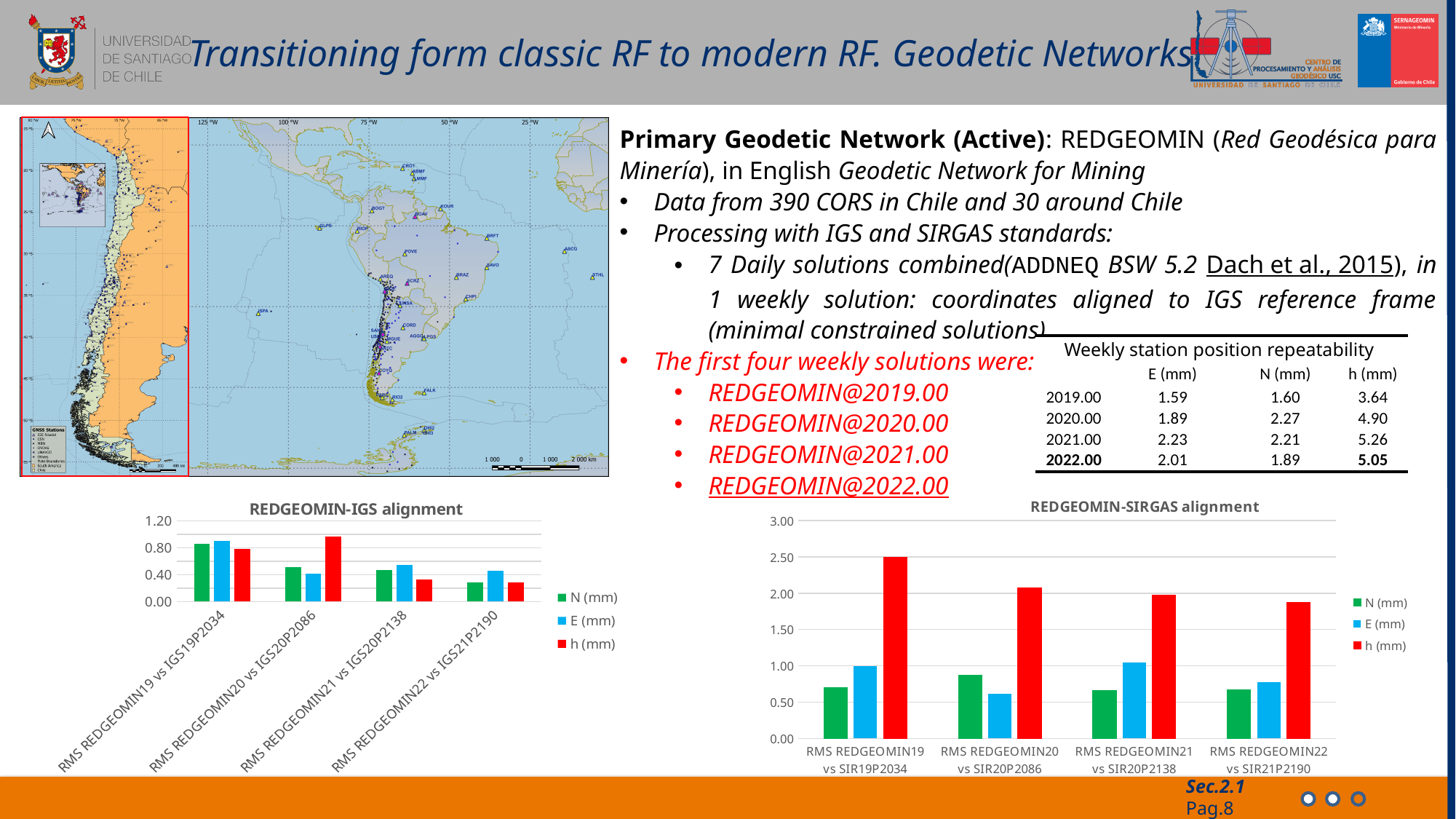
In the REDGEOMIN-IGS alignment chart, which is larger: the h (mm) value for RMS REDGEOMIN20 vs IGS20P2086 or for RMS REDGEOMIN21 vs IGS20P2138? RMS REDGEOMIN20 vs IGS20P2086 In the REDGEOMIN-IGS alignment chart, is the h (mm) value for RMS REDGEOMIN20 vs IGS20P2086 greater or less than 0.80? greater How many categories are shown on the x axis of the REDGEOMIN-SIRGAS alignment chart? 4 How many series does the legend of the REDGEOMIN-SIRGAS alignment chart list? 3 In the REDGEOMIN-SIRGAS alignment chart, is the h (mm) value for RMS REDGEOMIN19 vs SIR19P2034 greater or less than 2.00? greater In the REDGEOMIN-SIRGAS alignment chart, which colour represents the h (mm) series? red In the REDGEOMIN-SIRGAS alignment chart, which category has the highest h (mm) value? RMS REDGEOMIN19 vs SIR19P2034 What kind of chart is the REDGEOMIN-IGS alignment chart? bar chart In the REDGEOMIN-IGS alignment chart, is the N (mm) value for RMS REDGEOMIN22 vs IGS21P2190 greater or less than 0.40? less In the REDGEOMIN-IGS alignment chart, which category has the highest h (mm) value? RMS REDGEOMIN20 vs IGS20P2086 In the REDGEOMIN-SIRGAS alignment chart, do the h (mm) values rise or fall from left to right along the x axis? fall In the REDGEOMIN-SIRGAS alignment chart, which category has the lowest E (mm) value? RMS REDGEOMIN20 vs SIR20P2086